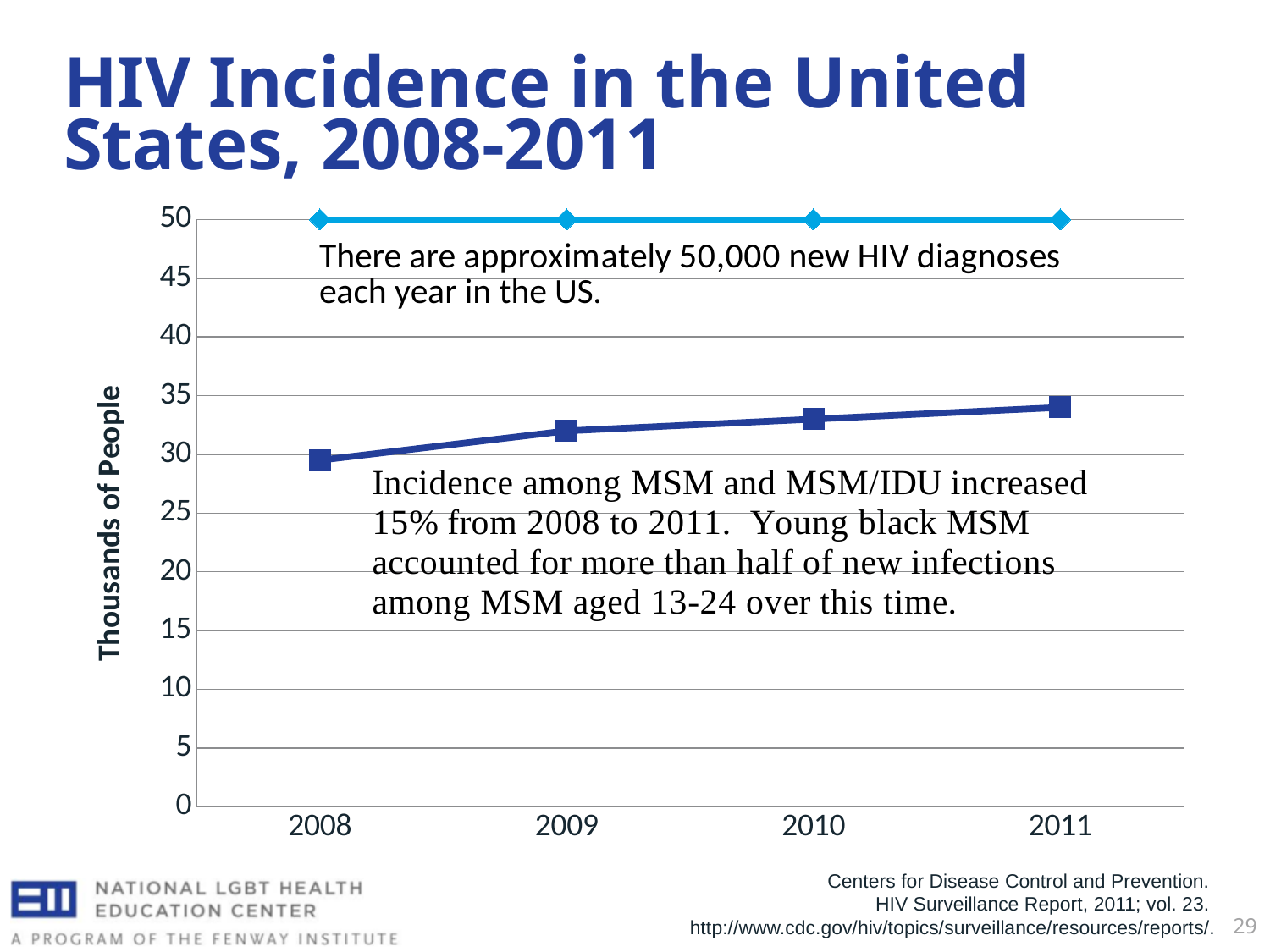
How many years are shown along the x axis of the chart? 4 Does the dark blue line rise or fall from 2008 to 2011? rises Is the value of the dark blue line for 2011 greater or less than 35? less What type of chart is shown on the slide? line chart What is the title of the chart on the slide? HIV Incidence in the United States, 2008-2011 In which year is the dark blue line at its lowest value? 2008 On the dark blue line, which year has the larger value, 2008 or 2011? 2011 What is the label on the vertical axis of the chart? Thousands of People What value does the light blue line sit at across all years? 50 In which year is the dark blue line at its highest value? 2011 Is the value of the dark blue line for 2008 greater or less than 25? greater Is the value of the dark blue line for 2010 greater or less than 30? greater